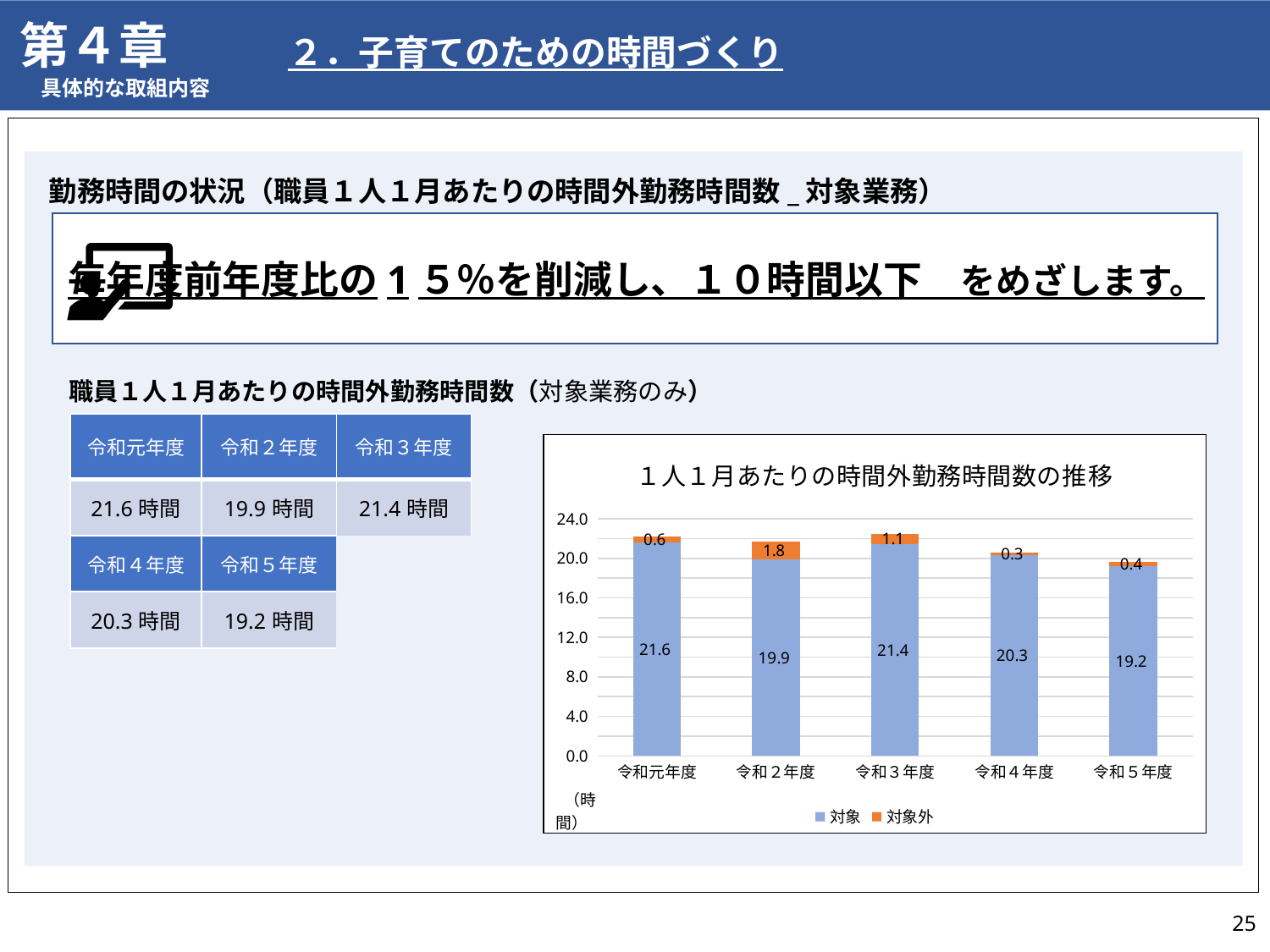
What is the title of the chart? １人１月あたりの時間外勤務時間数の推移 What is the total of the stacked bar for 令和４年度 (対象 plus 対象外)? 20.6 What type of chart is shown on the slide? Stacked bar chart Is the 対象 value for 令和５年度 greater or less than 20.0? less Which fiscal year has the highest 対象外 value in the chart? 令和２年度 How many series does the chart legend list? 2 Which fiscal year has the lowest 対象 value in the chart? 令和５年度 How many fiscal-year categories are shown on the x axis of the chart? 5 What is the value of 対象外 for 令和２年度 in the chart? 1.8 What is the value of 対象 for 令和３年度 in the chart? 21.4 Which is larger, the 対象 value for 令和２年度 or for 令和４年度? 令和４年度 What is the difference between the 対象 values for 令和元年度 and 令和５年度? 2.4